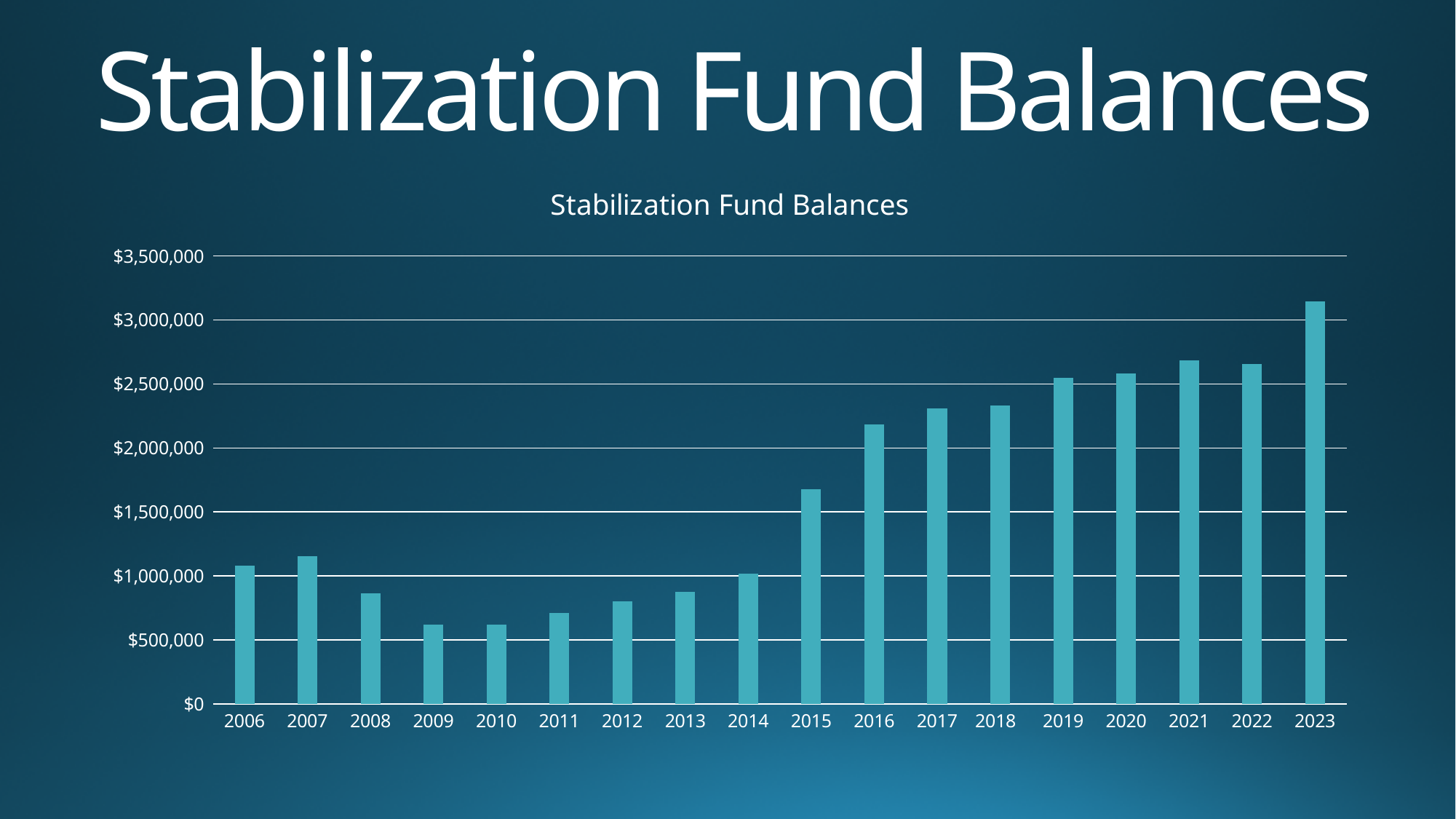
Is the value for 2016 greater or less than $2,000,000? greater Is the value for 2023 greater or less than $3,000,000? greater Is the value for 2015 greater or less than $1,500,000? greater Do the stabilization fund balances generally rise or fall from 2014 to 2023? rise How many years are plotted on the x axis of the chart? 18 Which year has the larger balance, 2006 or 2007? 2007 Which year has the highest stabilization fund balance? 2023 What is the title of the chart? Stabilization Fund Balances What kind of chart is shown on the slide? bar chart Which year has the larger balance, 2014 or 2015? 2015